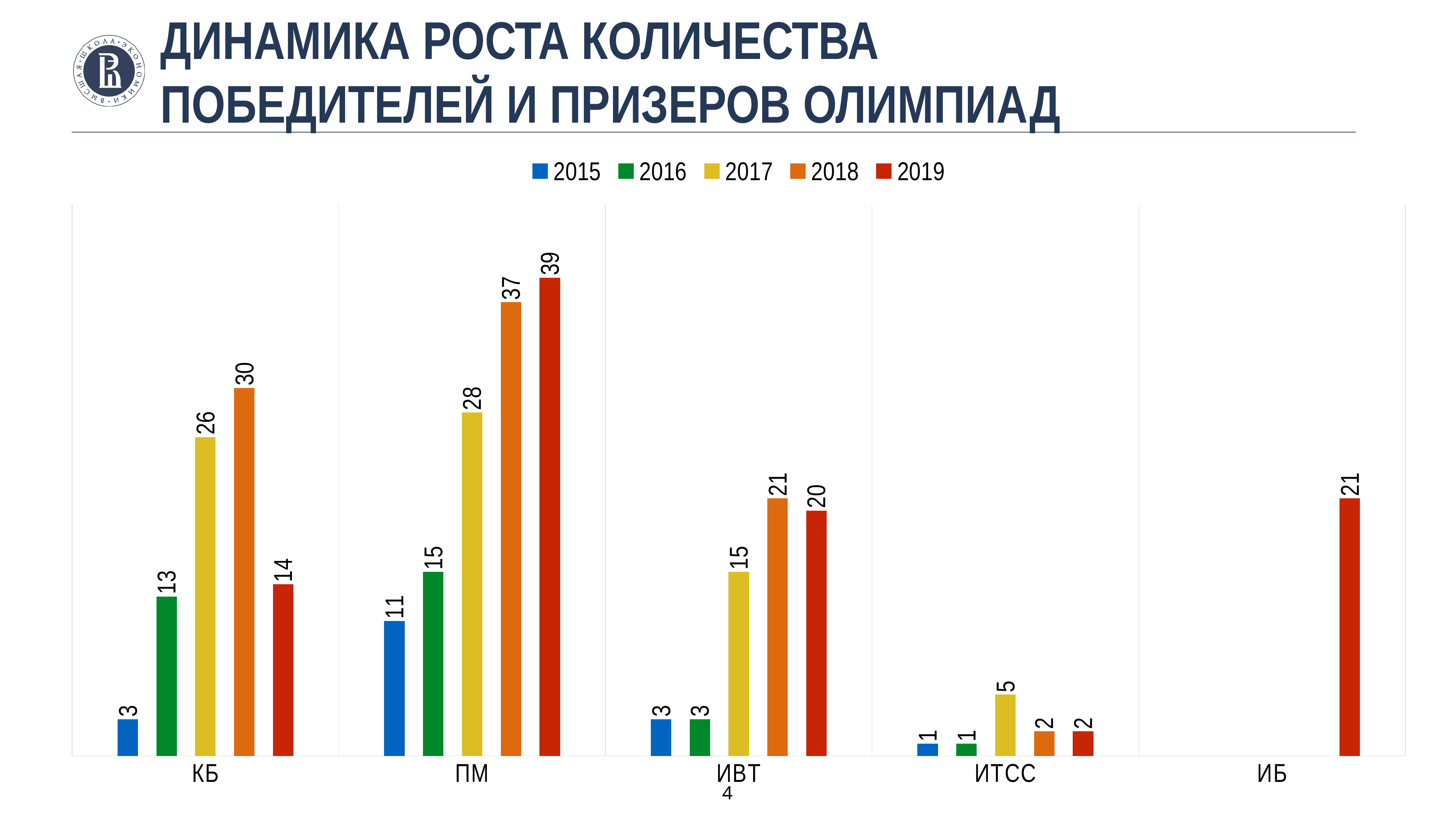
How many categories are shown on the x axis? 5 What is the value for КБ in 2018? 30 What is the difference between the 2019 and 2018 values for КБ? 16 Which category has the lowest value in 2017? ИТСС Which category has the highest value in 2018? ПМ Which is larger for ИВТ: the 2018 value or the 2019 value? 2018 What type of chart is shown on the slide? bar chart What is the value for ИБ in 2019? 21 What is the value for ИВТ in 2017? 15 What is the value for ПМ in 2019? 39 Which year is shown in blue in the legend? 2015 How many series does the legend list? 5